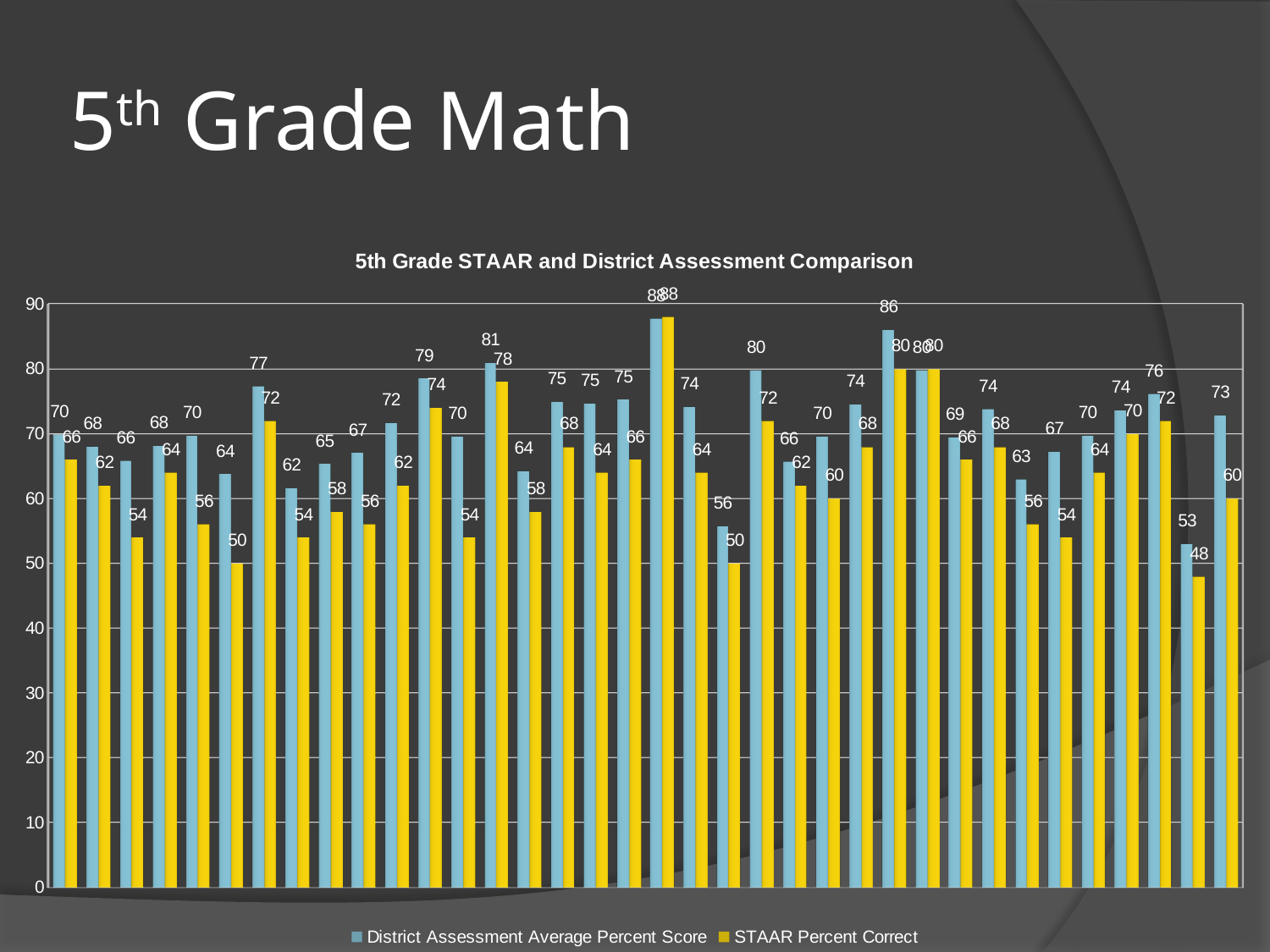
What is the difference between the highest and lowest District Assessment Average Percent Score values? 35 What is the lowest value shown for the District Assessment Average Percent Score series? 53 What is the highest value shown for the District Assessment Average Percent Score series? 88 What is the highest value shown for the STAAR Percent Correct series? 88 Which colour represents the STAAR Percent Correct series? yellow Is the lowest District Assessment Average Percent Score value greater or less than 50? greater How many series does the legend list? 2 Is the lowest STAAR Percent Correct value greater or less than 50? less What is the difference between the highest and lowest STAAR Percent Correct values? 40 What is the title of the chart? 5th Grade STAAR and District Assessment Comparison What is the lowest value shown for the STAAR Percent Correct series? 48 What kind of chart is shown on the slide? bar chart